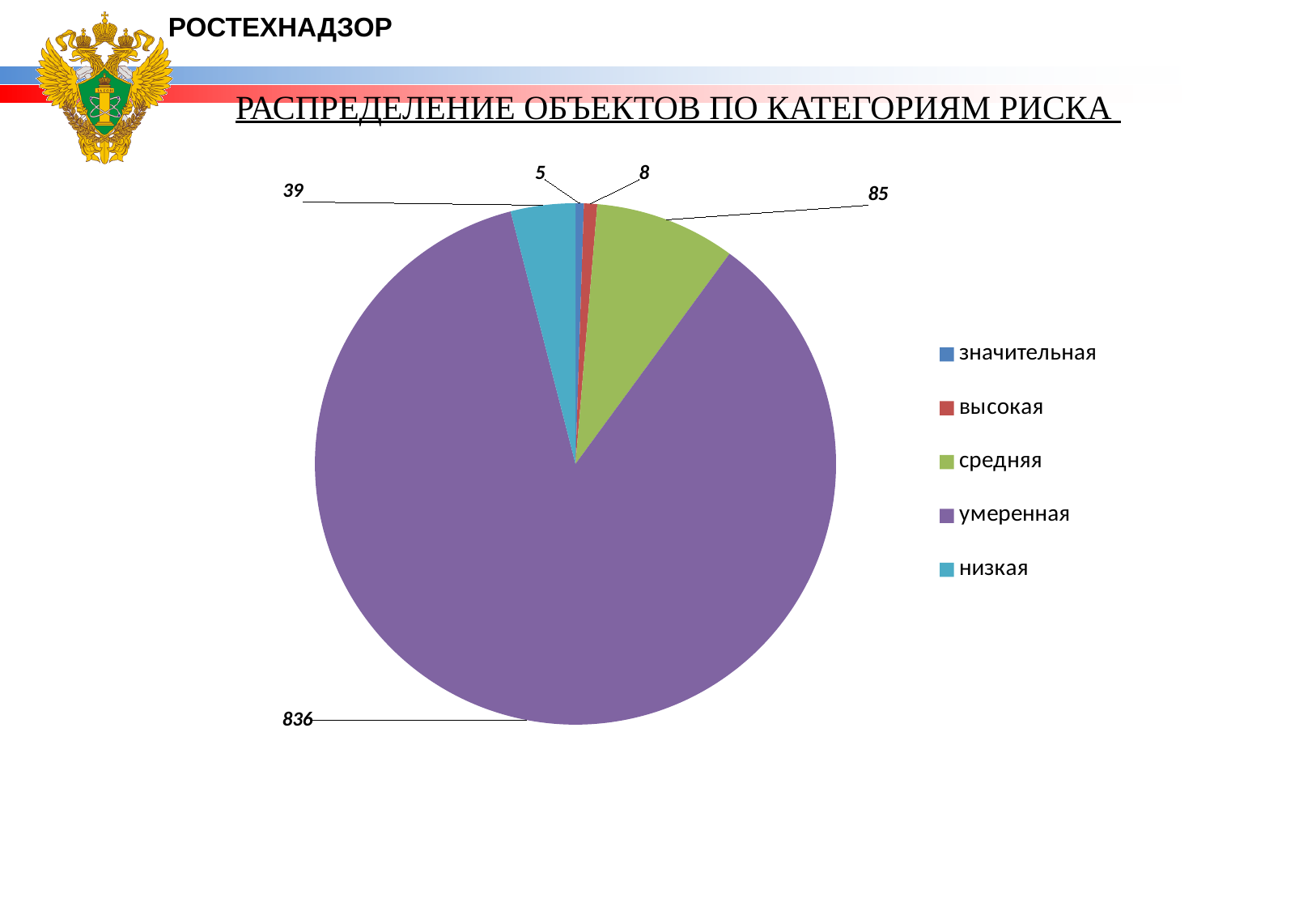
What type of chart is shown on the slide? pie chart What is the value for the низкая category? 39 Which category has the smallest slice of the pie? значительная How many categories does the legend list? 5 Which is larger, the value for высокая or the value for значительная? высокая What is the difference between the values for средняя and низкая? 46 What is the value for the умеренная category? 836 What is the value for the средняя category? 85 What is the value for the значительная category? 5 Which category has the largest slice of the pie? умеренная What is the value for the высокая category? 8 What is the title of the chart? РАСПРЕДЕЛЕНИЕ ОБЪЕКТОВ ПО КАТЕГОРИЯМ РИСКА